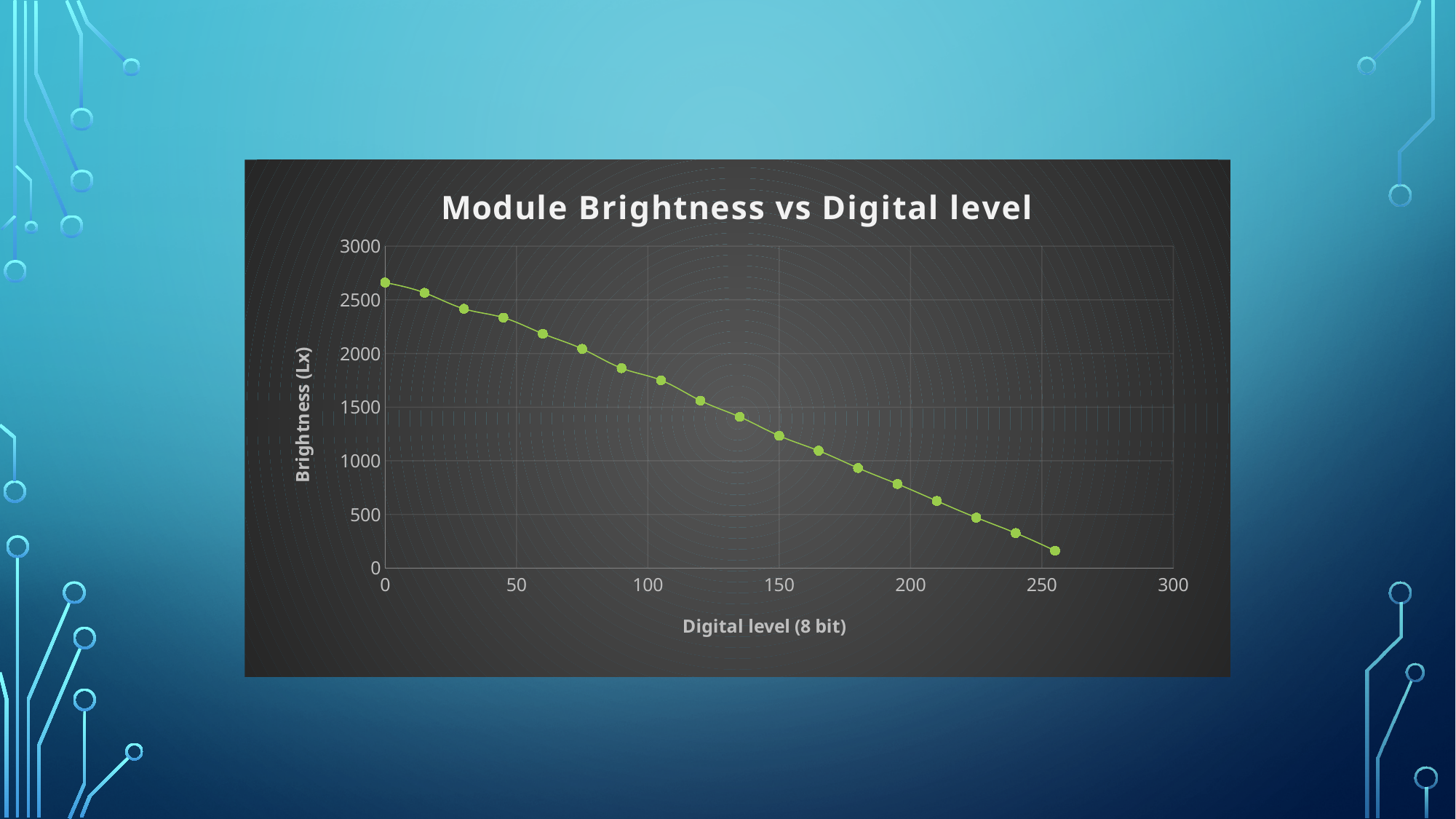
What is the title of the chart? Module Brightness vs Digital level Which has the higher brightness: digital level 90 or digital level 180? Digital level 90 Is the brightness at digital level 60 greater or less than 2000? greater How many data points are plotted on the line? 18 At which digital level is the brightness highest? 0 Do the brightness values rise or fall as the digital level increases? Fall Is the brightness at digital level 150 greater or less than 1500? less At which digital level is the brightness lowest? 255 What kind of chart is shown on the slide? Line chart Is the brightness at digital level 255 greater or less than 500? less What is the label of the vertical axis? Brightness (Lx)